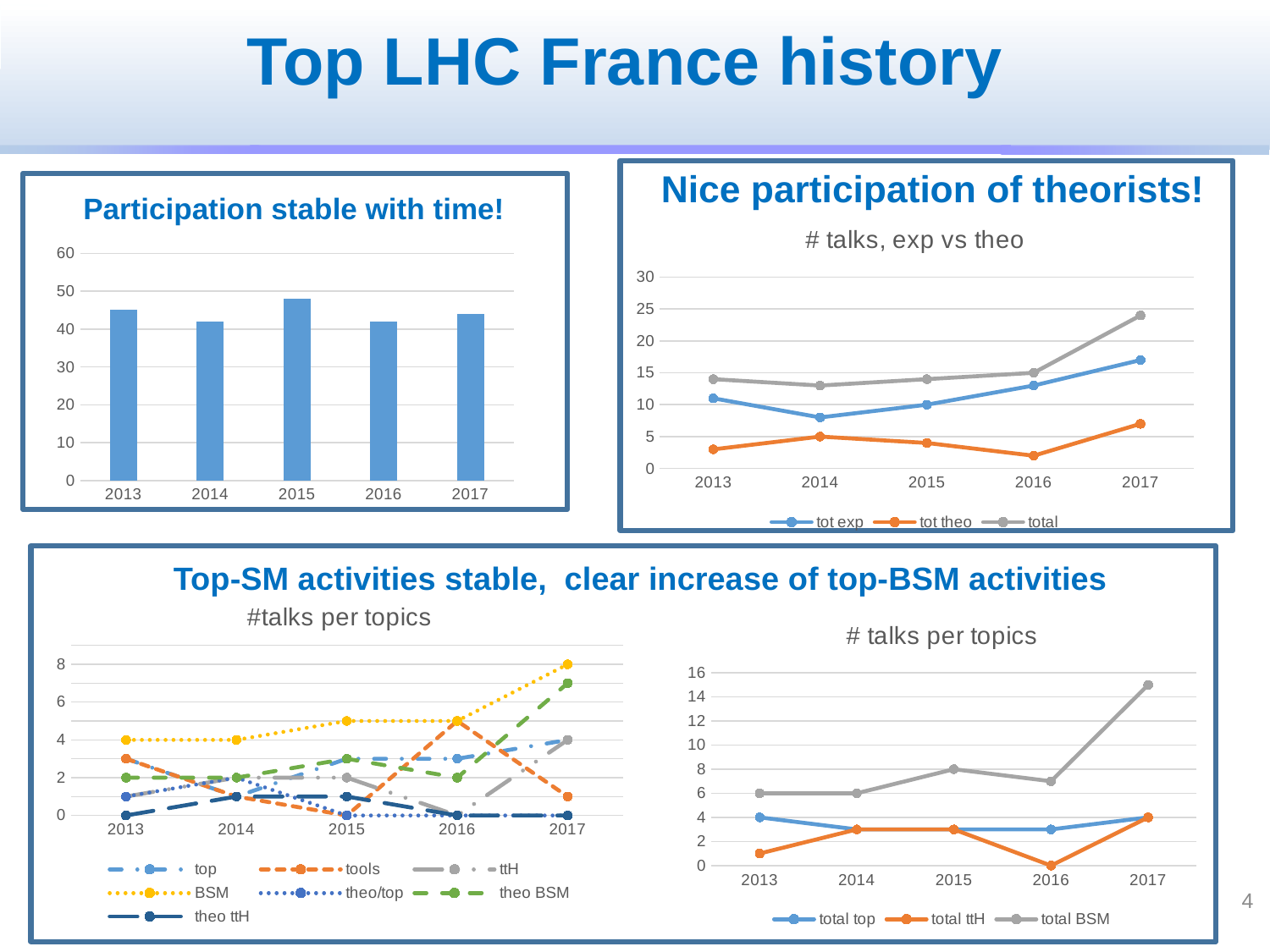
In the bottom-right '# talks per topics' chart, is the value of total BSM in 2017 greater or less than 14? greater How many series does the legend of the bottom-left '#talks per topics' chart list? 7 In the '# talks, exp vs theo' chart, which series has the highest value in 2017? total In the bottom-right '# talks per topics' chart, what is the value of total BSM in 2015? 8 In the 'Participation stable with time!' chart, is the value for 2013 greater or less than 40? greater In the bottom-right '# talks per topics' chart, which series has the highest value in 2017? total BSM What kind of chart is the 'Participation stable with time!' chart? bar chart In the '# talks, exp vs theo' chart, does the total series rise or fall from 2016 to 2017? rise In the 'Participation stable with time!' chart, which year has the highest bar? 2015 How many series does the legend of the '# talks, exp vs theo' chart list? 3 How many bars are shown in the 'Participation stable with time!' chart? 5 In the '# talks, exp vs theo' chart, is the value of tot exp in 2017 greater or less than 15? greater